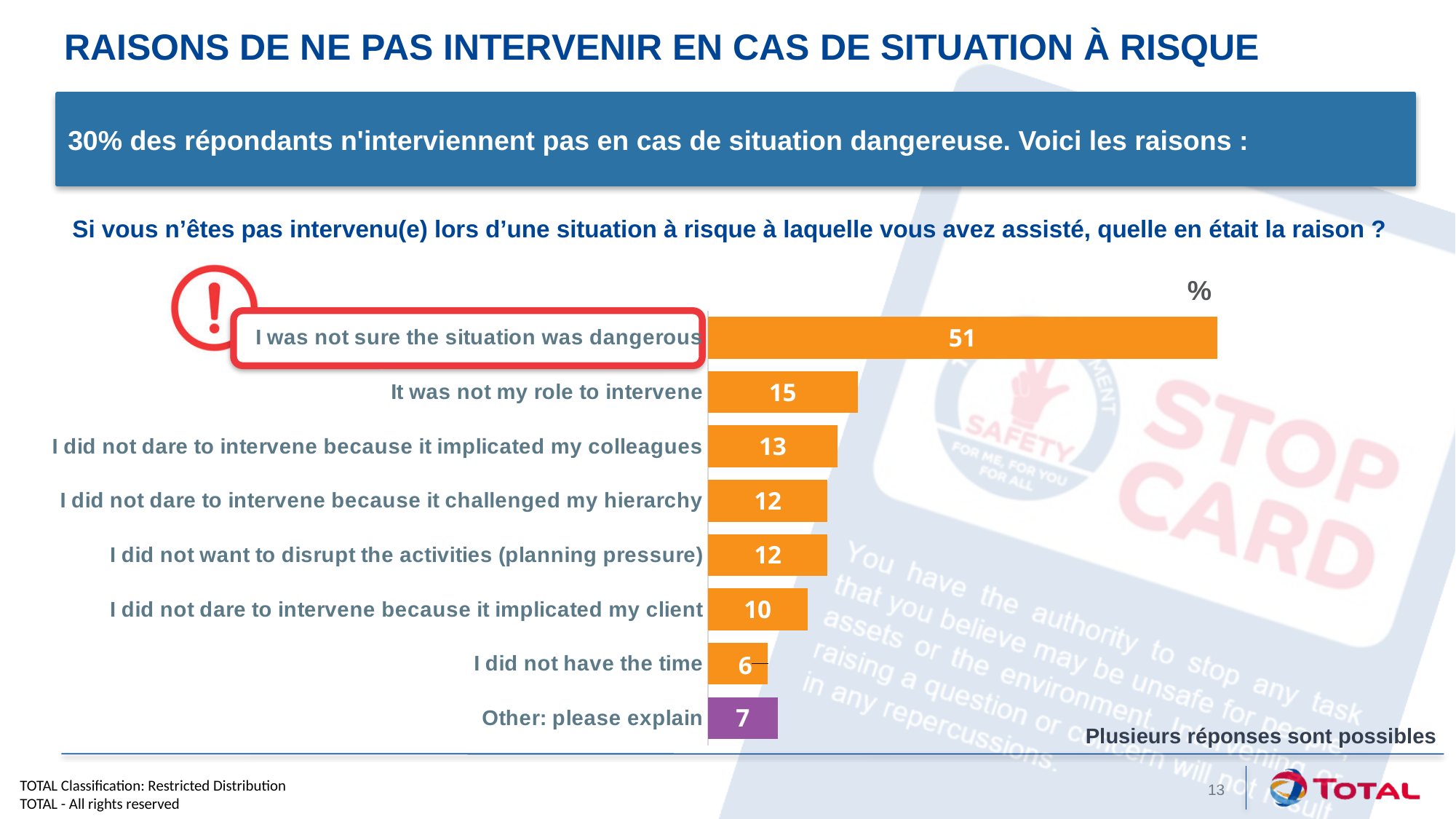
What is the value for "Other: please explain"? 7 How many reasons (categories) are shown in the chart? 8 What unit is indicated above the bars in the chart? % What is the value for "It was not my role to intervene"? 15 What is the value for "I did not dare to intervene because it implicated my client"? 10 What colour is the bar for "Other: please explain"? Purple Which reason has the lowest value? I did not have the time Which is larger: the value for "It was not my role to intervene" or for "I did not dare to intervene because it implicated my colleagues"? It was not my role to intervene What is the value for "I was not sure the situation was dangerous"? 51 Which reason has the highest value? I was not sure the situation was dangerous What kind of chart is shown on the slide? Bar chart What is the difference between the values for "I was not sure the situation was dangerous" and "It was not my role to intervene"? 36